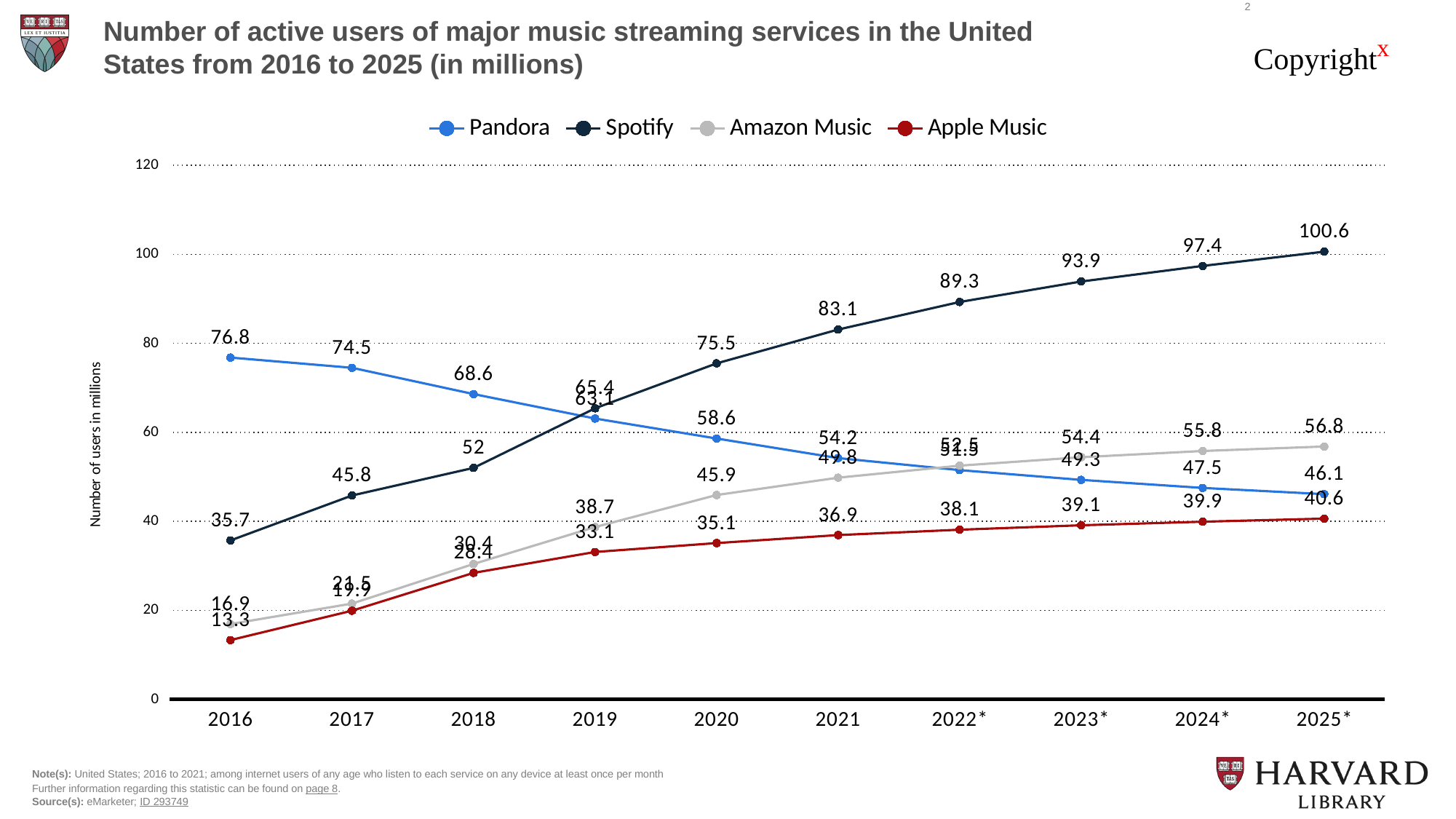
How many years are shown along the x axis? 10 What is the difference between Spotify and Pandora in 2025*? 54.5 What is the value for Pandora in 2016? 76.8 Do the values for Pandora rise or fall from 2016 to 2025*? fall How many series does the legend list? 4 What kind of chart is shown on the slide? line chart Which service has the highest number of active users in 2025*? Spotify What is the value for Apple Music in 2020? 35.1 What is the value for Spotify in 2025*? 100.6 Which service has the lowest number of active users in 2016? Apple Music Is the value for Amazon Music in 2024* greater or less than 60? less Which is larger in 2016, Pandora or Spotify? Pandora